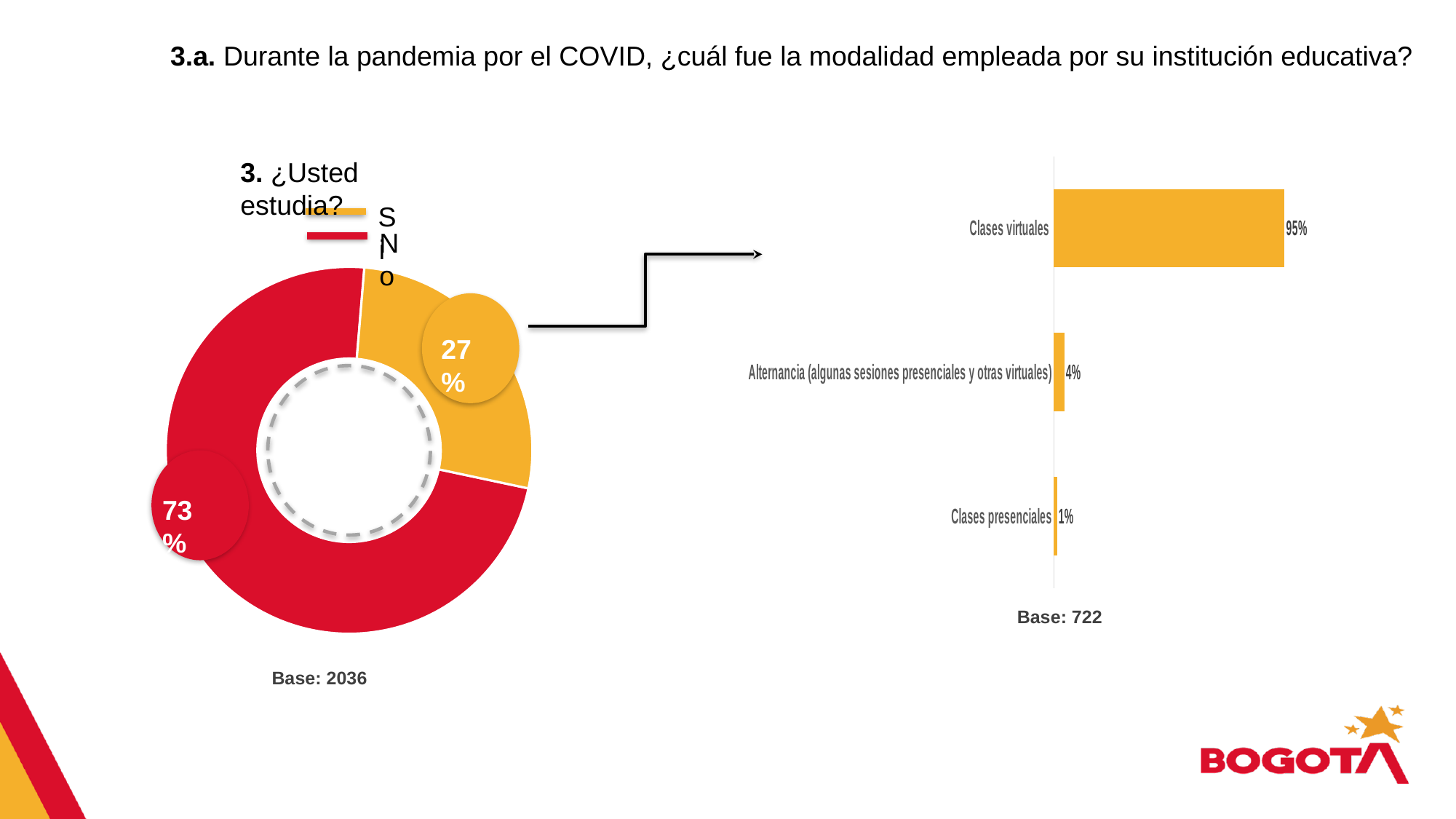
In the donut chart on the left, which is larger, the red slice or the orange slice? The red slice In the bar chart on the right, which category has the highest value? Clases virtuales In the donut chart on the left, what share is shown for the orange slice? 27% What base (number of respondents) is shown under the bar chart on the right? Base: 722 In the bar chart on the right, what is the value for Clases presenciales? 1% In the bar chart on the right, what is the value for Alternancia (algunas sesiones presenciales y otras virtuales)? 4% In the bar chart on the right, what is the difference between Clases virtuales and Alternancia? 91% What kind of chart is the chart on the right of the slide? Bar chart In the bar chart on the right, what is the value for Clases virtuales? 95% In the bar chart on the right, how many categories are shown? 3 In the donut chart on the left, what share is shown for the red 'No' slice? 73% In the bar chart on the right, which category has the lowest value? Clases presenciales